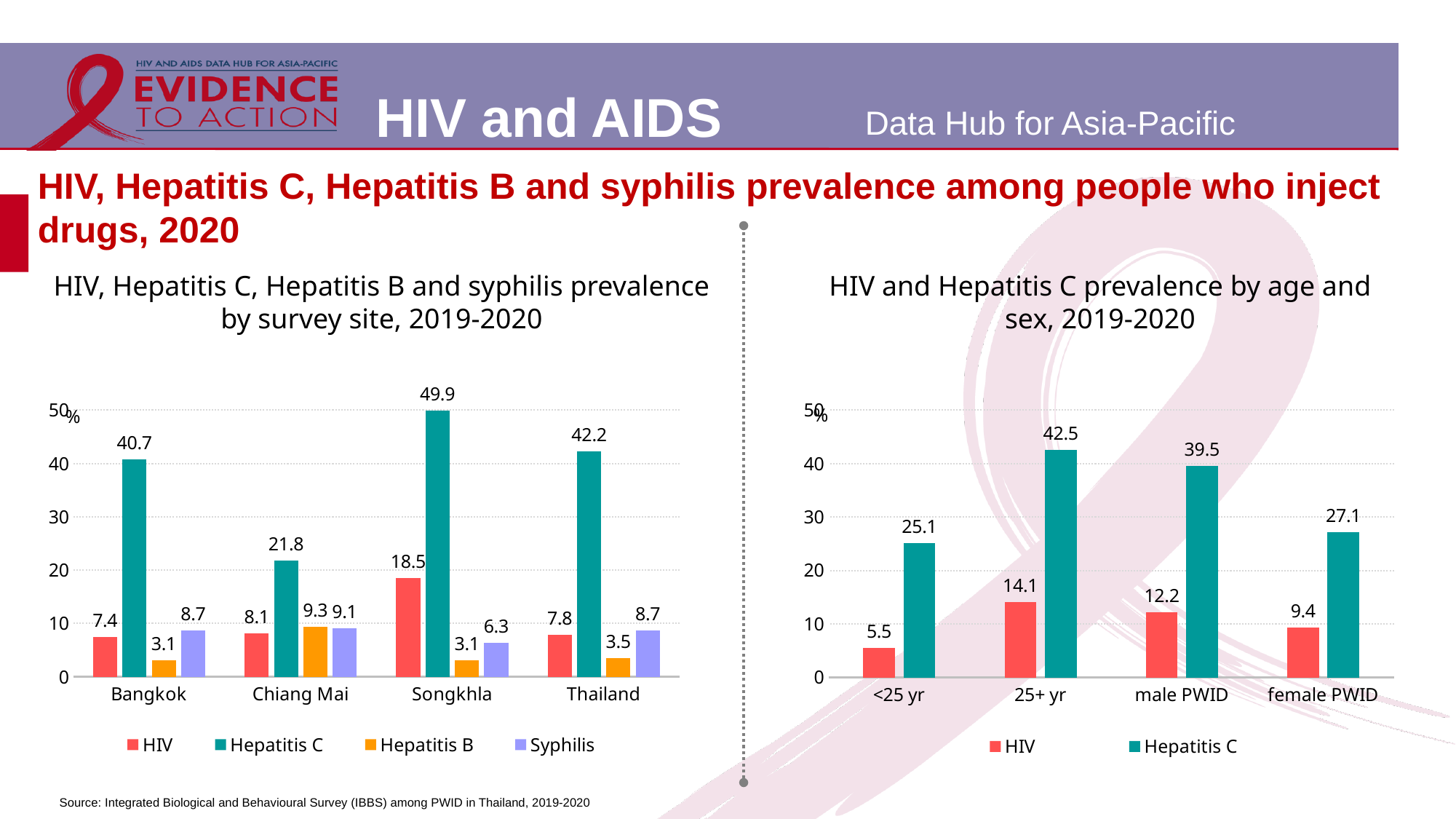
In the right chart (prevalence by age and sex), which category has the highest HIV value? 25+ yr In the left chart (prevalence by survey site), which survey site has the highest Hepatitis C value? Songkhla In the right chart (prevalence by age and sex), what is the difference between the HIV values for male PWID and female PWID? 2.8 In the left chart (prevalence by survey site), which survey site has the lowest Syphilis value? Songkhla What kind of chart is the right chart (prevalence by age and sex)? Bar chart In the right chart (prevalence by age and sex), how many categories are shown on the x axis? 4 In the left chart (prevalence by survey site), which is larger for Chiang Mai: Hepatitis B or Syphilis? Hepatitis B In the left chart (prevalence by survey site), how many series does the legend list? 4 In the left chart (prevalence by survey site), what is the HIV value for Bangkok? 7.4 In the left chart (prevalence by survey site), what is the difference between the Hepatitis C values for Thailand and Bangkok? 1.5 In the right chart (prevalence by age and sex), what is the Hepatitis C value for male PWID? 39.5 In the left chart (prevalence by survey site), what is the Hepatitis C value for Songkhla? 49.9